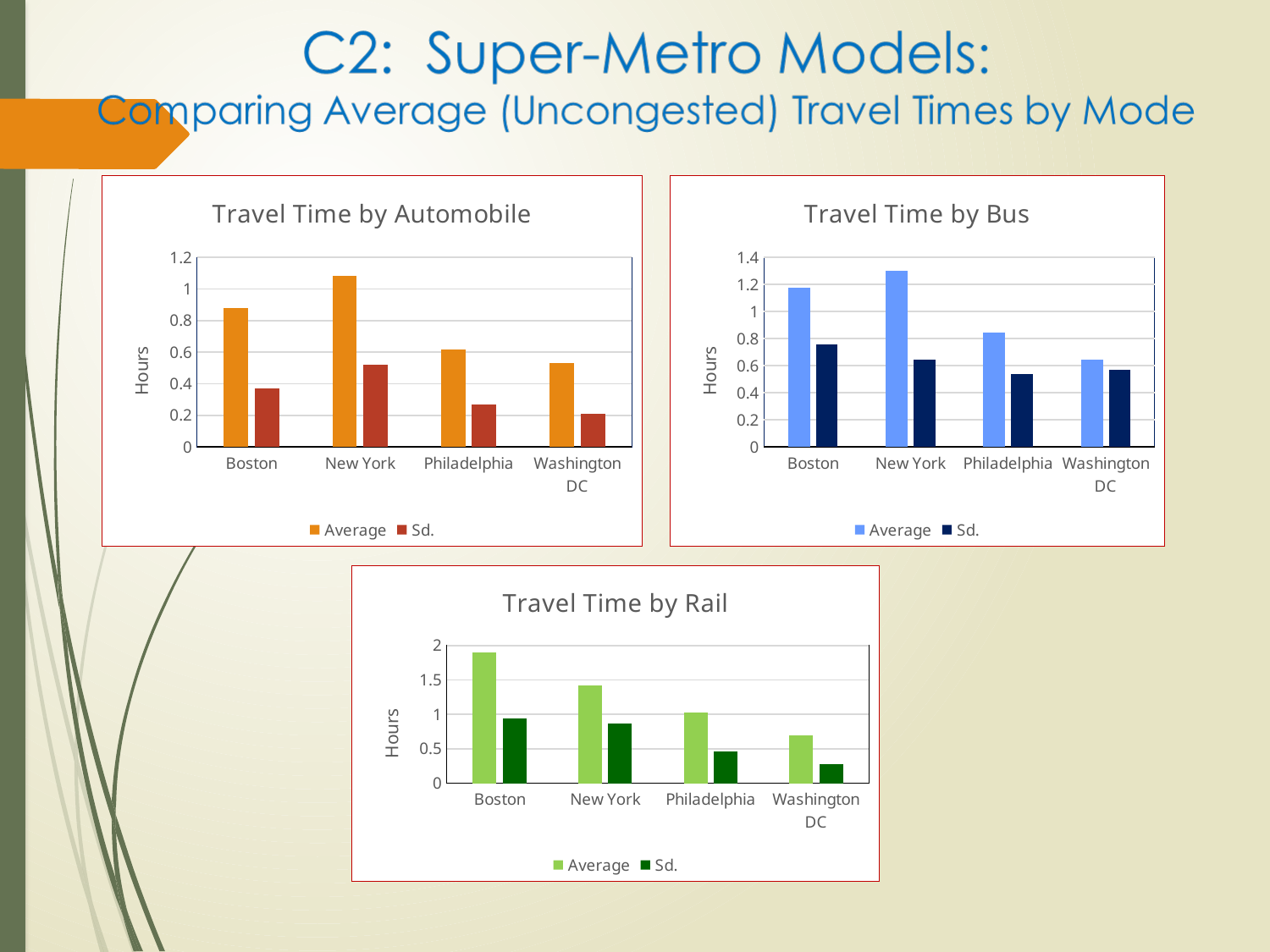
In the Travel Time by Rail chart, is the Sd. value for Washington DC greater or less than 0.5? less In the Travel Time by Bus chart, is the Average value for Boston greater or less than 1? greater In the Travel Time by Automobile chart, which city has the highest Average travel time? New York In the Travel Time by Bus chart, which city has the highest Sd. value? Boston In the Travel Time by Rail chart, do the Average values rise or fall from Boston to Washington DC? fall In the Travel Time by Automobile chart, is the Average value for New York greater or less than 1? greater In the Travel Time by Rail chart, which is larger, the Average for Philadelphia or the Average for Washington DC? Philadelphia In the Travel Time by Automobile chart, which city has the lowest Sd. value? Washington DC How many series does the legend of the Travel Time by Bus chart list? 2 In the Travel Time by Bus chart, which city has the lowest Average travel time? Washington DC In the Travel Time by Rail chart, which city has the highest Average travel time? Boston